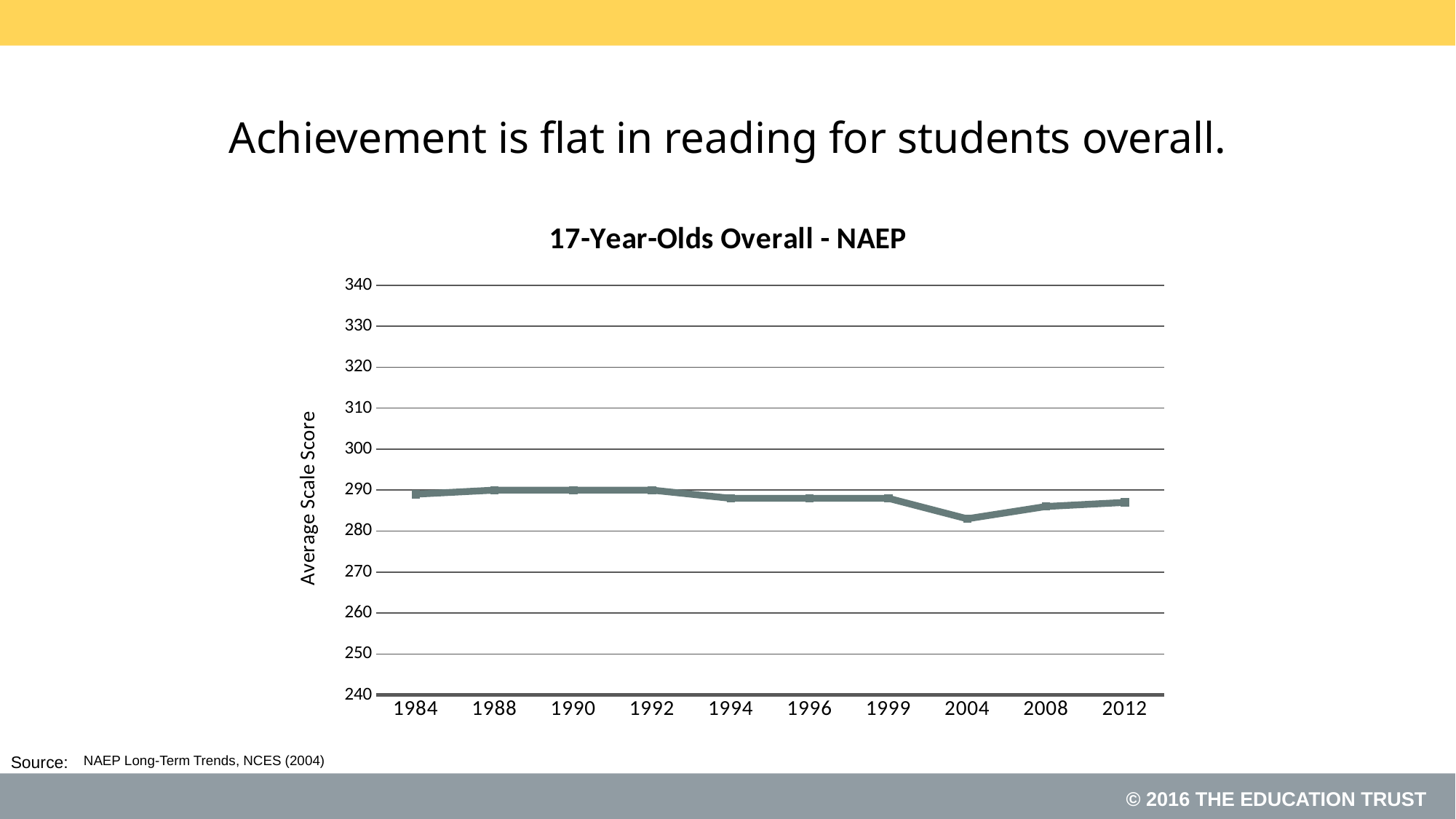
Which year has the larger average scale score, 1992 or 2004? 1992 What is the label on the vertical axis of the chart? Average Scale Score Is the value for 2004 greater or less than 290? less Is the value for 1984 greater or less than 280? greater Which year has the lowest average scale score on the chart? 2004 Is the value for 2004 greater or less than 280? greater What kind of chart is shown on the slide? line chart What is the title of the chart? 17-Year-Olds Overall - NAEP How many years are plotted along the x axis of the chart? 10 Do the values rise or fall from 2004 to 2012? rise Do the values rise or fall from 1992 to 2004? fall